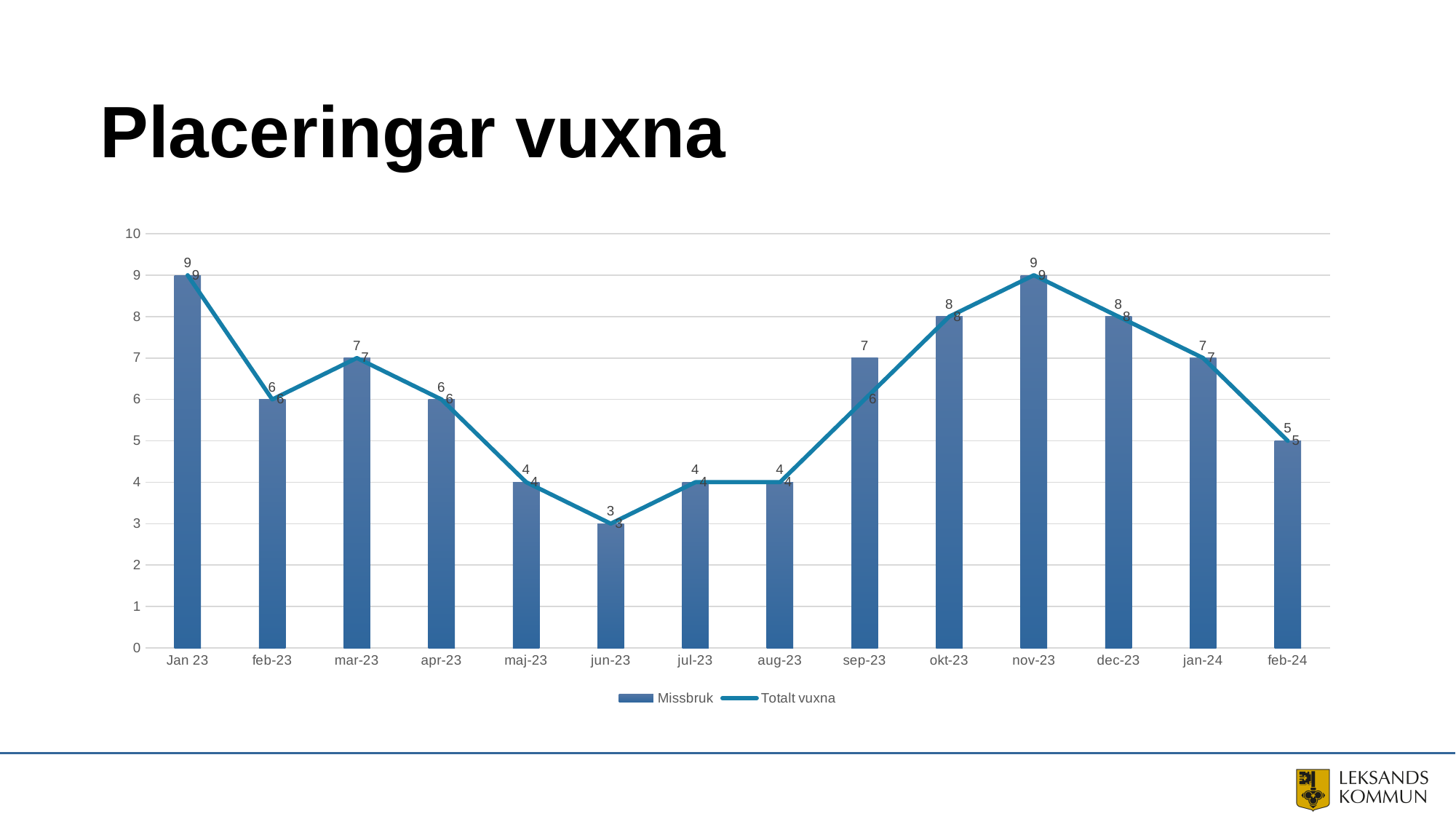
Which is larger, the Missbruk value for mar-23 or for apr-23? mar-23 How many series does the legend list? 2 What kind of chart is shown on the slide? Combined bar and line chart What is the Missbruk value for jun-23? 3 How many months are shown on the x axis? 14 Do the Missbruk values rise or fall from aug-23 to nov-23? Rise What is the title of the slide? Placeringar vuxna What is the Missbruk value for nov-23? 9 What is the difference between the Missbruk values for okt-23 and maj-23? 4 What is the Missbruk value for sep-23? 7 What is the Totalt vuxna value for feb-24? 5 Which month has the lowest Missbruk value? jun-23